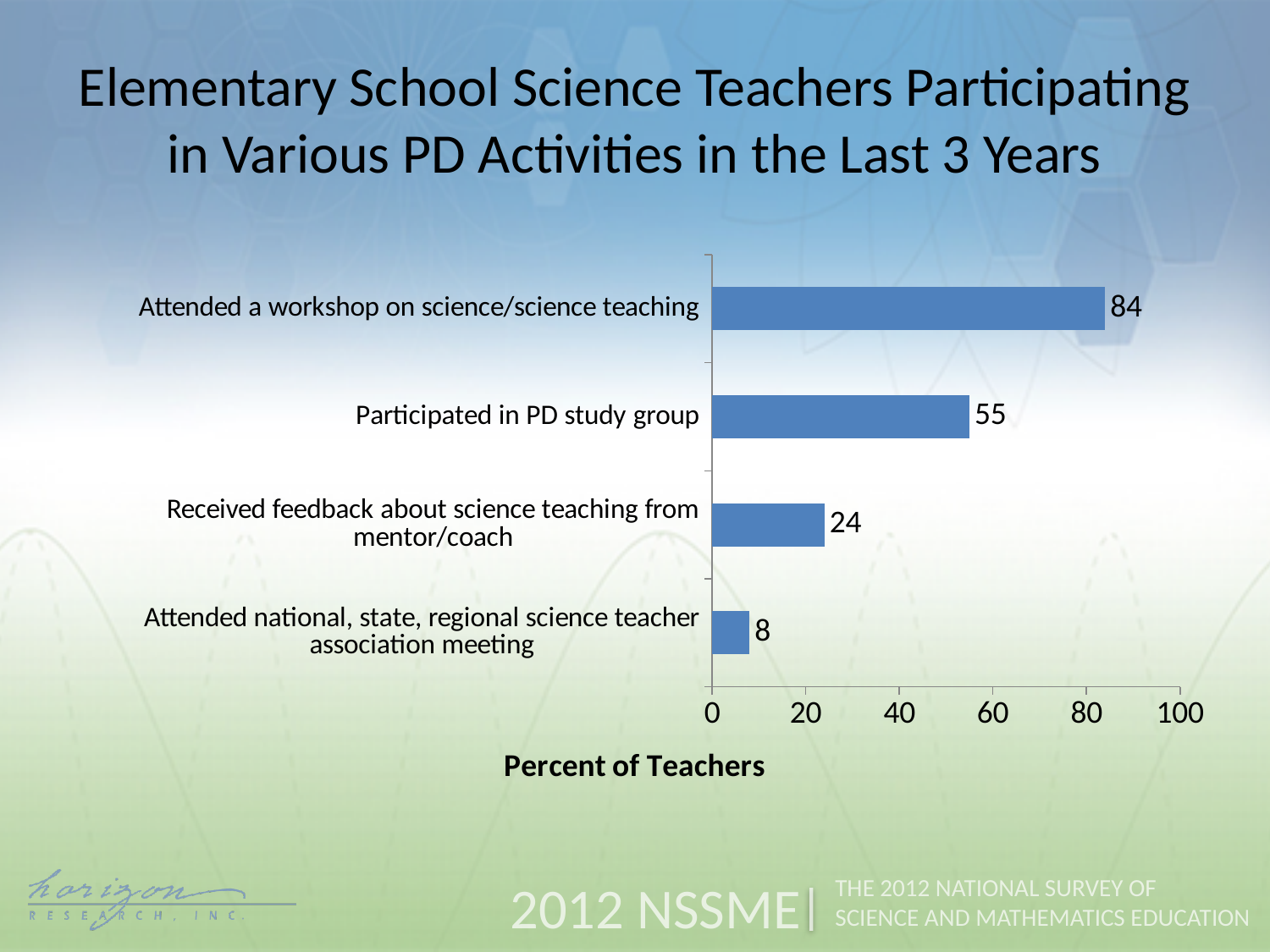
Which is larger: the percent who participated in a PD study group or the percent who received feedback from a mentor/coach? Participated in PD study group What is the difference between the value for receiving feedback from a mentor/coach and attending a science teacher association meeting? 16 How many PD activities are shown in the chart? 4 What is the label of the horizontal axis? Percent of Teachers What is the value for 'Attended national, state, regional science teacher association meeting'? 8 Which PD activity has the lowest percent of teachers participating? Attended national, state, regional science teacher association meeting What is the value for 'Participated in PD study group'? 55 What percent of elementary school science teachers attended a workshop on science/science teaching? 84 What kind of chart is shown on the slide? Bar chart What is the difference in percent between attending a workshop and participating in a PD study group? 29 Which PD activity has the highest percent of teachers participating? Attended a workshop on science/science teaching What percent of teachers received feedback about science teaching from a mentor/coach? 24